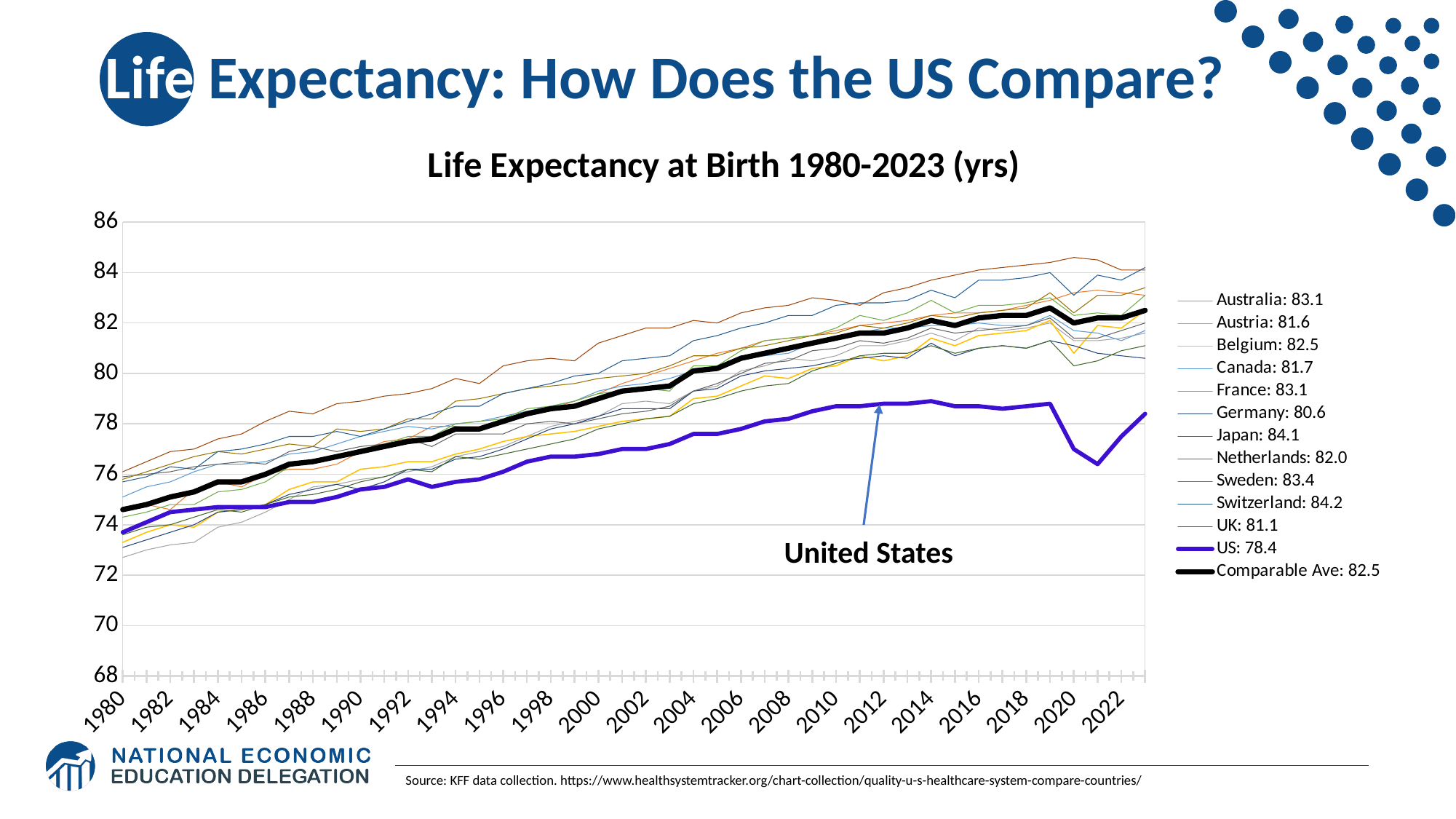
What value is shown for the US in the legend? 78.4 Which has a higher legend value, Germany or the UK? UK Does the Comparable Ave line generally rise or fall from 1980 to 2023? rise What type of chart is shown on the slide? line chart How many series does the legend list? 13 Which series has the lowest value in the legend? US Which series has the highest value in the legend? Switzerland What value is shown for the Comparable Ave in the legend? 82.5 What is the title of the chart? Life Expectancy at Birth 1980-2023 (yrs) What value is shown for Japan in the legend? 84.1 Is the value for the US in 2000 greater or less than 78? less What is the difference between the Comparable Ave value and the US value shown in the legend? 4.1